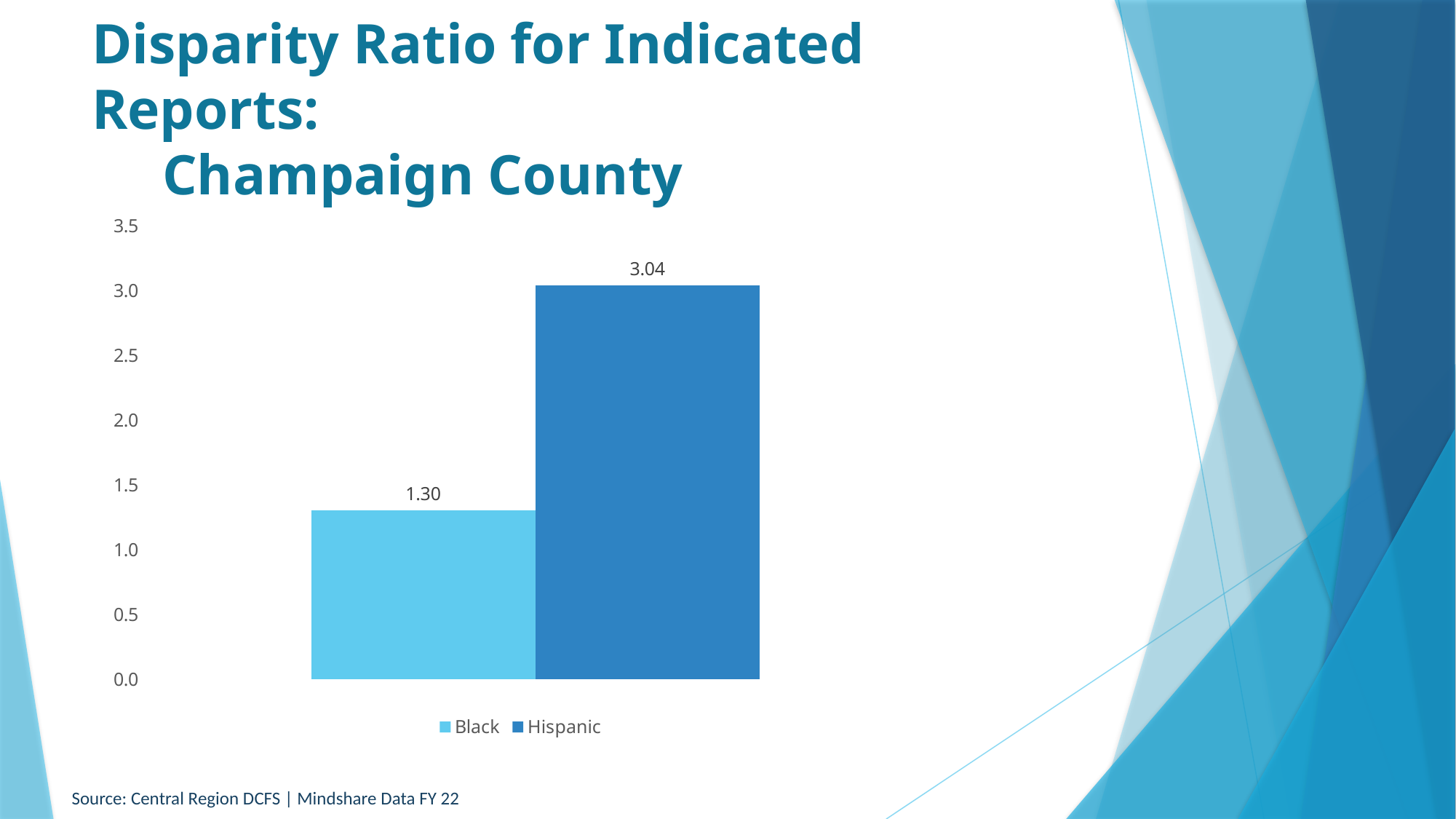
Which is larger, the disparity ratio for Black or for Hispanic? Hispanic Is the disparity ratio for Hispanic greater or less than 3.0? greater What kind of chart is shown on the slide? Bar chart Which series has the highest disparity ratio? Hispanic How many bars are plotted in the chart? 2 What is the difference between the Hispanic and Black disparity ratios? 1.74 What is the maximum value shown on the vertical axis? 3.5 Which series has the lowest disparity ratio? Black How many series does the legend list? 2 What is the disparity ratio for Black? 1.30 What is the disparity ratio for Hispanic? 3.04 Is the disparity ratio for Black greater or less than 1.5? less